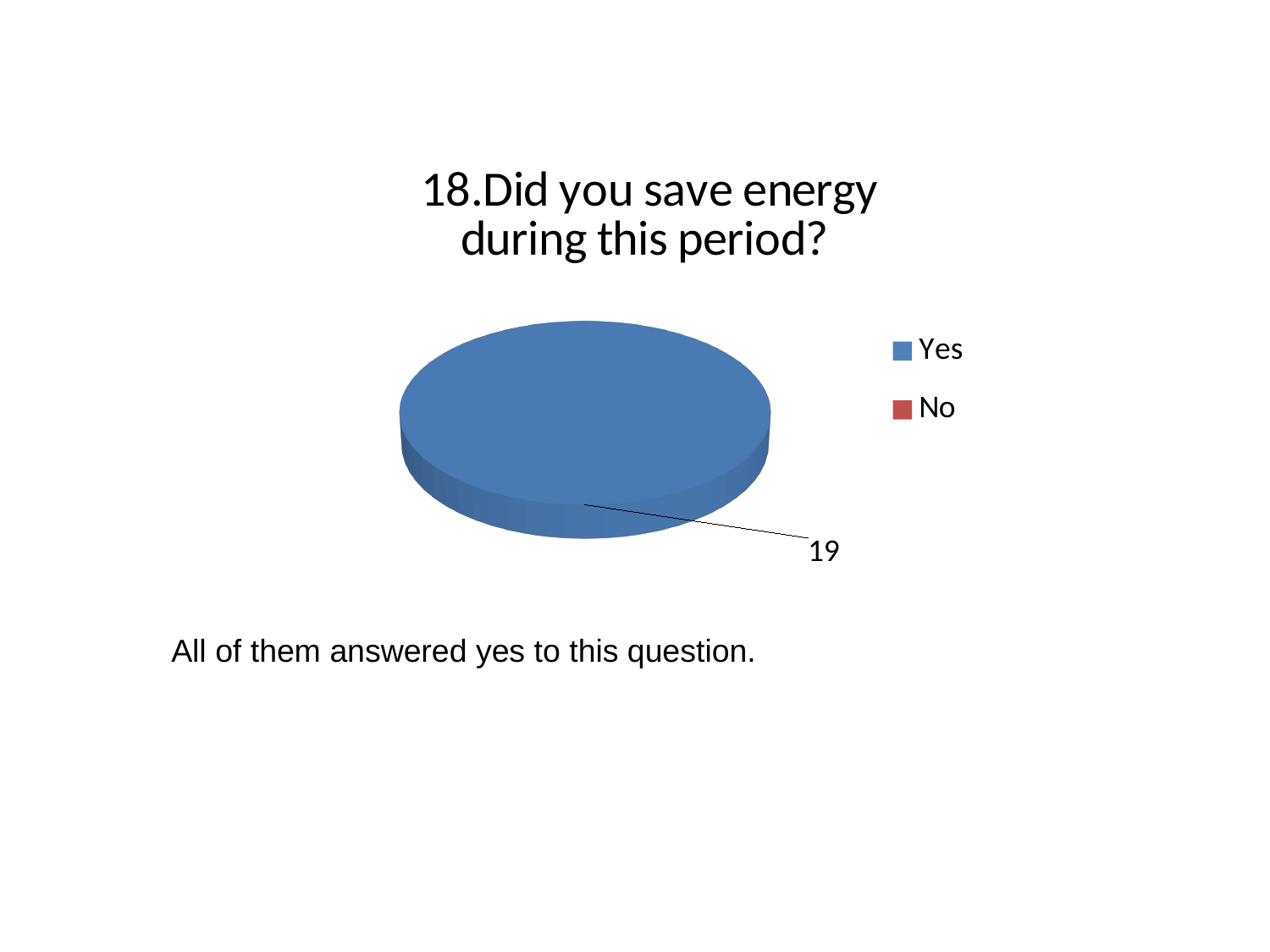
What colour is the Yes slice? blue Is the value for Yes greater or less than 10? greater Which is larger, the value for Yes or the value for No? Yes What kind of chart is shown on the slide? pie chart Which category has the largest slice of the pie? Yes How many entries does the legend list? 2 What is the value for Yes? 19 What is the title of the chart? 18.Did you save energy during this period?